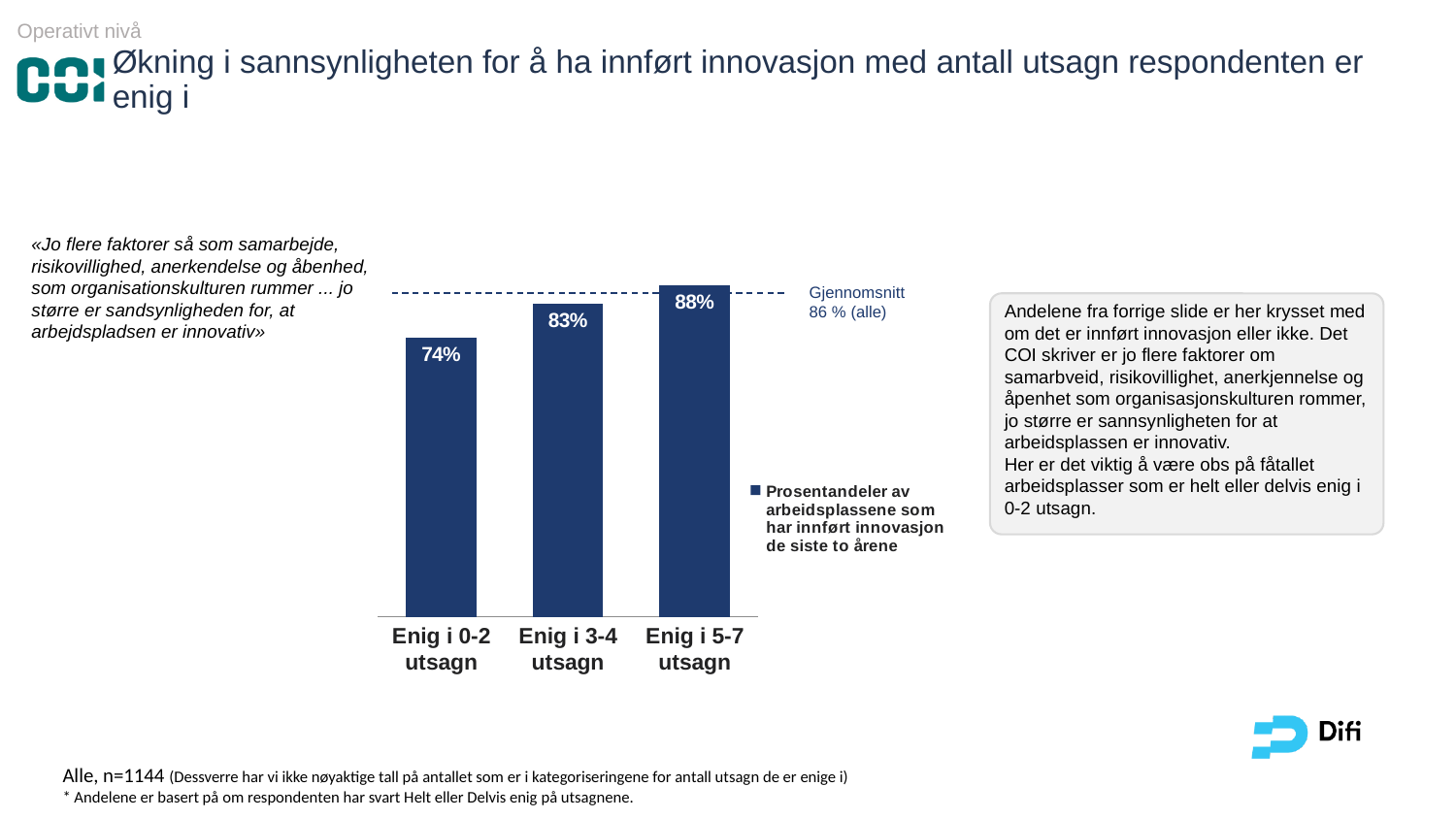
How many categories are shown in the chart? 3 What is the value for 'Enig i 5-7 utsagn'? 88% What kind of chart is shown on the slide? Bar chart Do the values rise or fall from left to right across the categories? Rise Which category has the highest value? Enig i 5-7 utsagn Which category has the lowest value? Enig i 0-2 utsagn Which is larger, the value for 'Enig i 3-4 utsagn' or 'Enig i 5-7 utsagn'? Enig i 5-7 utsagn What is the difference between the values for 'Enig i 5-7 utsagn' and 'Enig i 0-2 utsagn'? 14% What is the value for 'Enig i 3-4 utsagn'? 83% What is the value for 'Enig i 0-2 utsagn'? 74% What is the difference between the values for 'Enig i 3-4 utsagn' and 'Enig i 0-2 utsagn'? 9% What average value (Gjennomsnitt) is indicated by the dashed line on the chart? 86 % (alle)